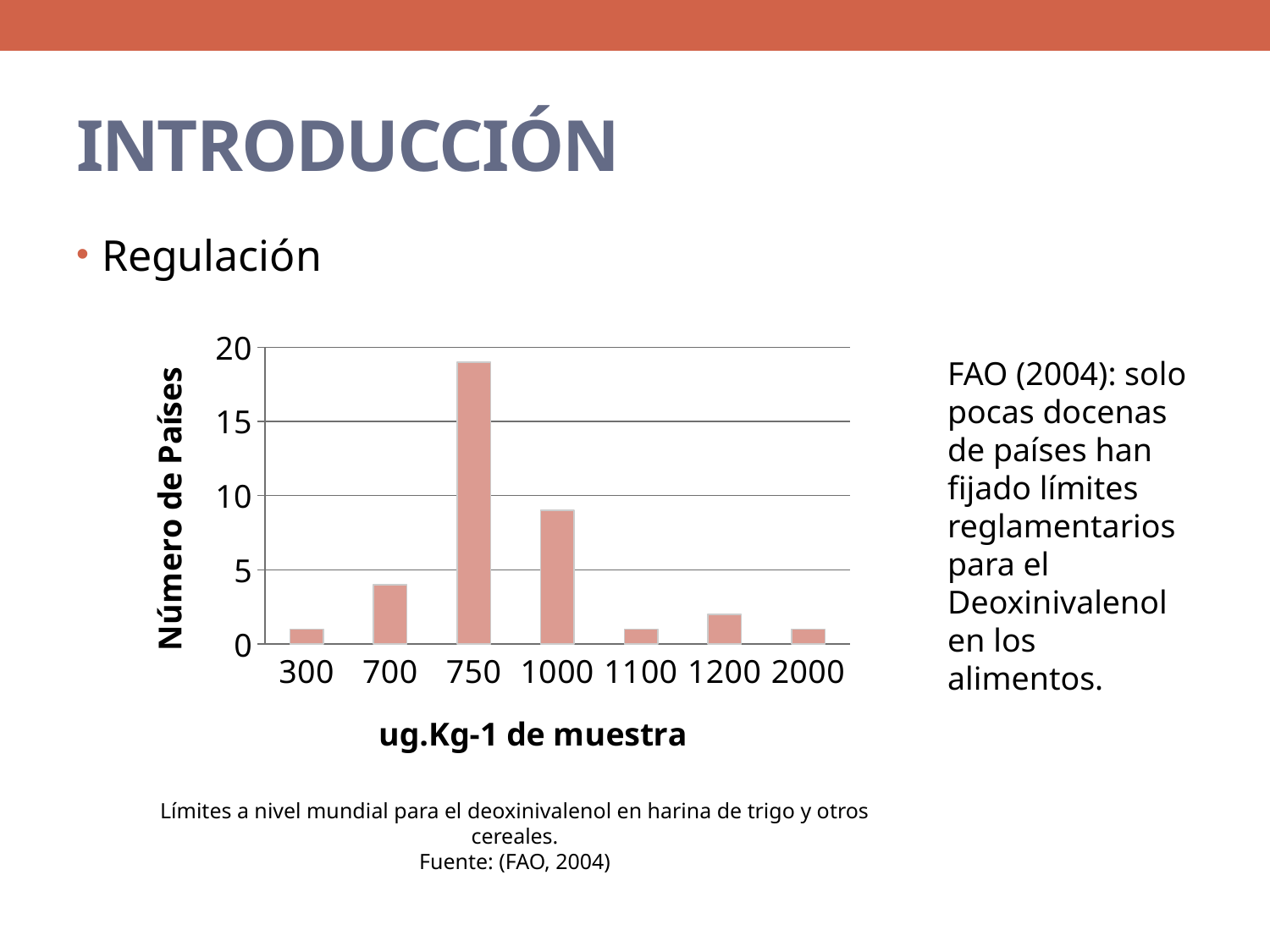
Which is larger, the value for 750 or the value for 1000? 750 How many categories are shown on the x axis of the chart? 7 Which is larger, the value for 700 or the value for 1200? 700 Is the value for 1000 greater or less than 10? less What is the title of the y axis of the chart? Número de Países Is the value for 300 greater or less than 5? less What is the title of the x axis of the chart? ug.Kg-1 de muestra Which category has the highest number of countries (Número de Países)? 750 Is the value for 700 greater or less than 5? less What kind of chart is shown on the slide? bar chart